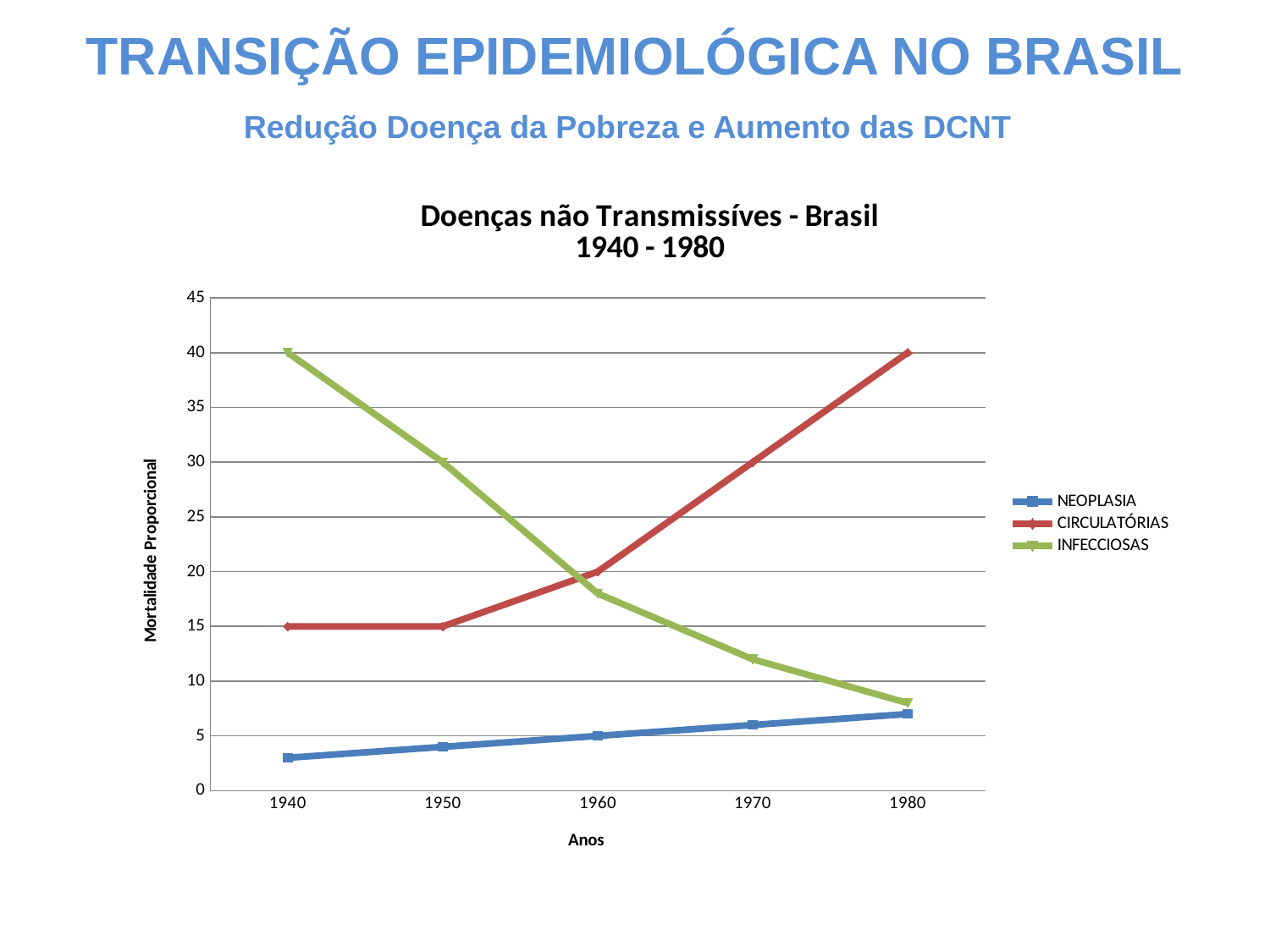
Is the value for INFECCIOSAS in 1980 greater or less than 10? less What is the difference between the CIRCULATÓRIAS values in 1980 and 1940? 25 What kind of chart is shown on the slide? line chart Which series has the lowest value in 1940? NEOPLASIA What is the value for CIRCULATÓRIAS in 1960? 20 What is the value for NEOPLASIA in 1960? 5 What is the value for CIRCULATÓRIAS in 1980? 40 How many years are plotted along the x axis? 5 Do the INFECCIOSAS values rise or fall from 1940 to 1980? fall What is the value for INFECCIOSAS in 1940? 40 Which series has the highest value in 1980? CIRCULATÓRIAS How many series does the legend list? 3